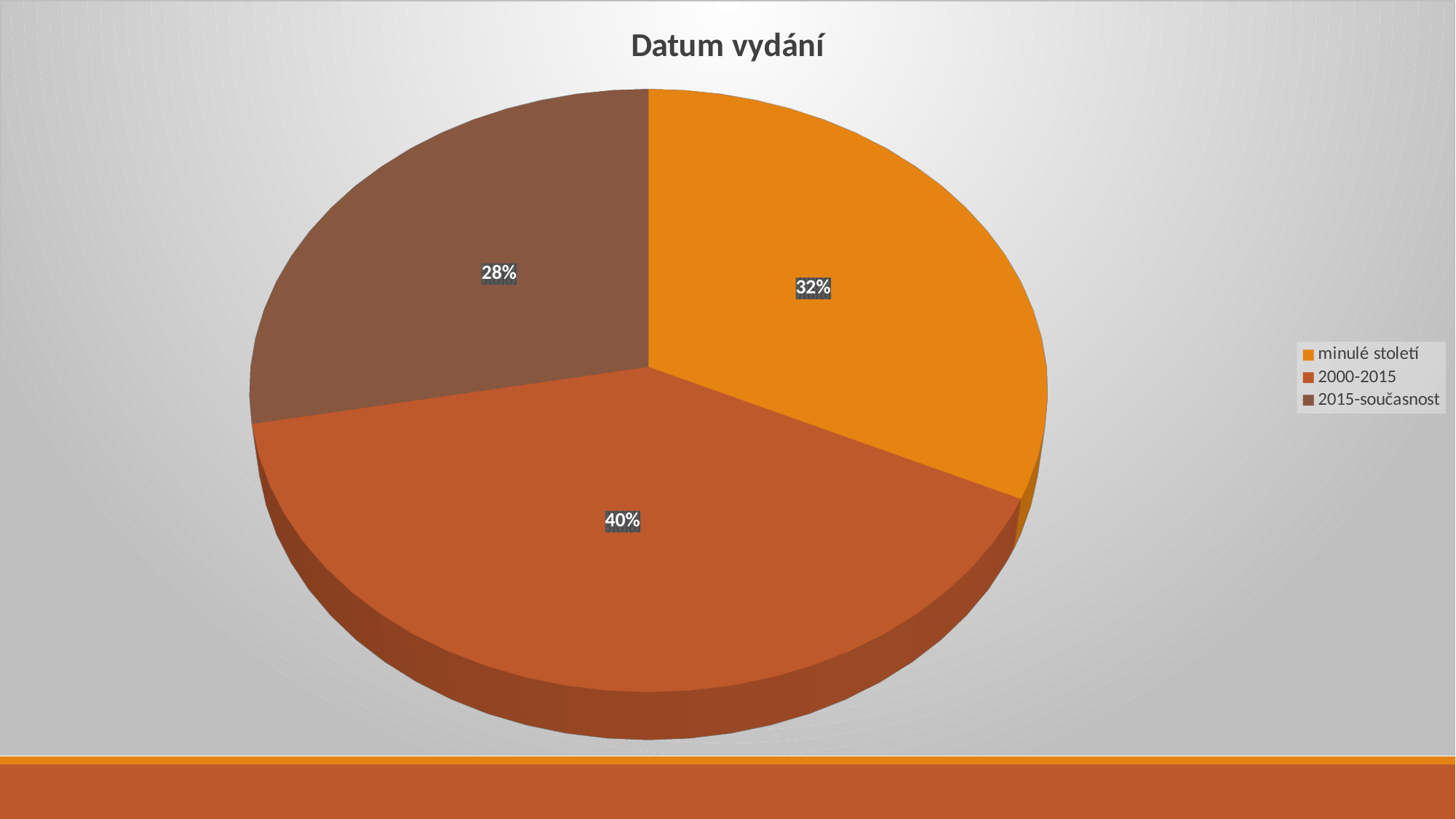
What is the title of the chart? Datum vydání What type of chart is shown on the slide? pie chart What share of the pie does the 'minulé století' slice represent? 32% How many categories are shown in the pie chart? 3 What is the difference in percentage points between the '2000-2015' slice and the '2015-současnost' slice? 12 What share of the pie does the '2000-2015' slice represent? 40% What is the difference in percentage points between the 'minulé století' slice and the '2015-současnost' slice? 4 Which is larger, the 'minulé století' slice or the '2000-2015' slice? 2000-2015 Which category has the largest slice of the pie? 2000-2015 How many entries does the legend list? 3 Which category has the smallest slice of the pie? 2015-současnost What share of the pie does the '2015-současnost' slice represent? 28%